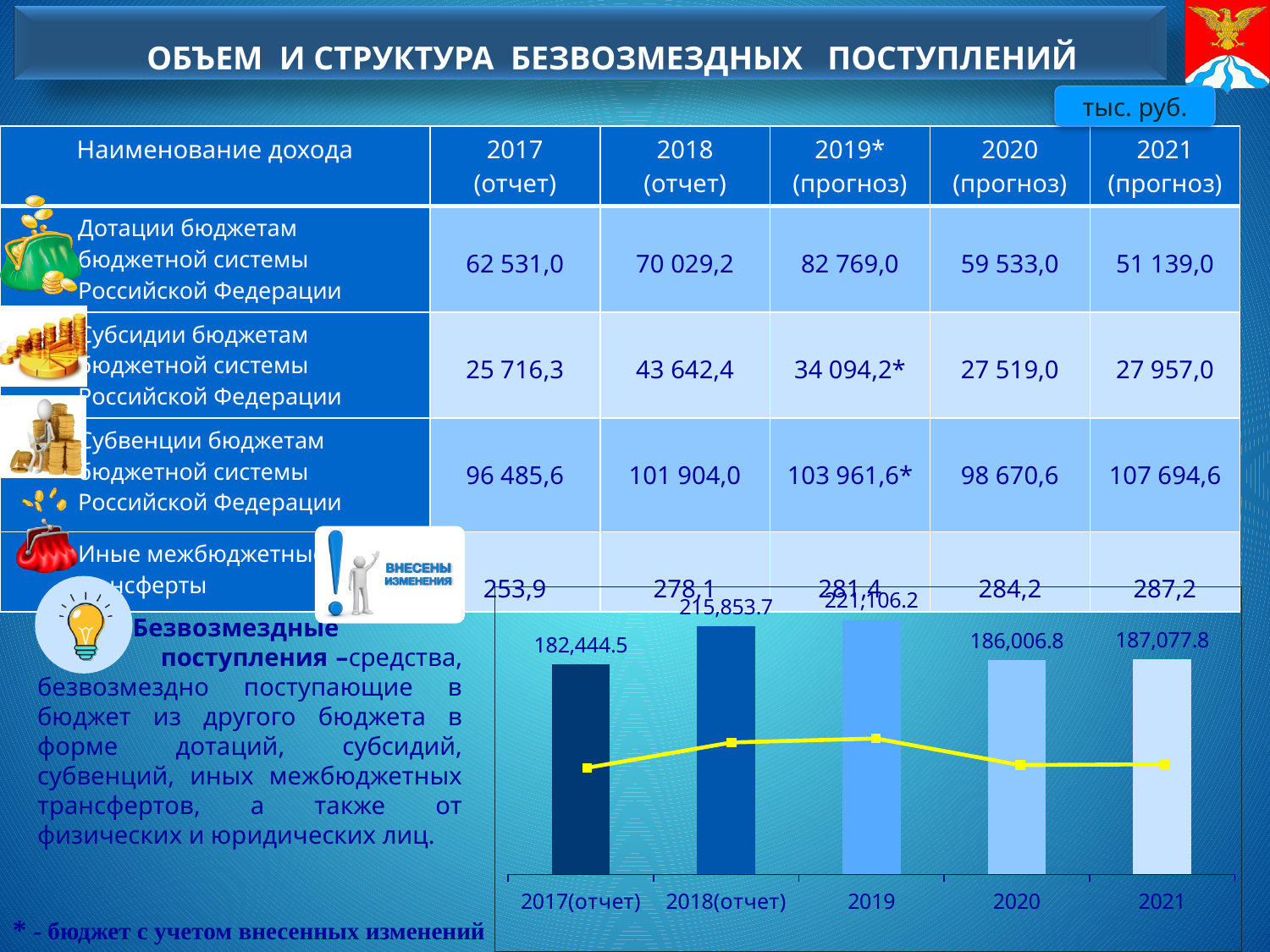
What kind of chart is shown at the bottom right of the slide? Bar chart (with a line overlay) What value is shown for 2019 in the bar chart? 221,106.2 What value is shown for 2020 in the bar chart? 186,006.8 Which year has the highest bar in the chart? 2019 What value is shown for 2017(отчет) in the bar chart? 182,444.5 How many years (bars) are shown in the bar chart? 5 What value is shown for 2021 in the bar chart? 187,077.8 What is the difference between the 2019 and 2020 values in the bar chart? 35,099.4 What value is shown for 2018(отчет) in the bar chart? 215,853.7 Which year has the lowest bar in the chart? 2017(отчет) What is the difference between the 2018(отчет) and 2017(отчет) values in the bar chart? 33,409.2 In the bar chart, which is larger: the value for 2020 or the value for 2021? 2021